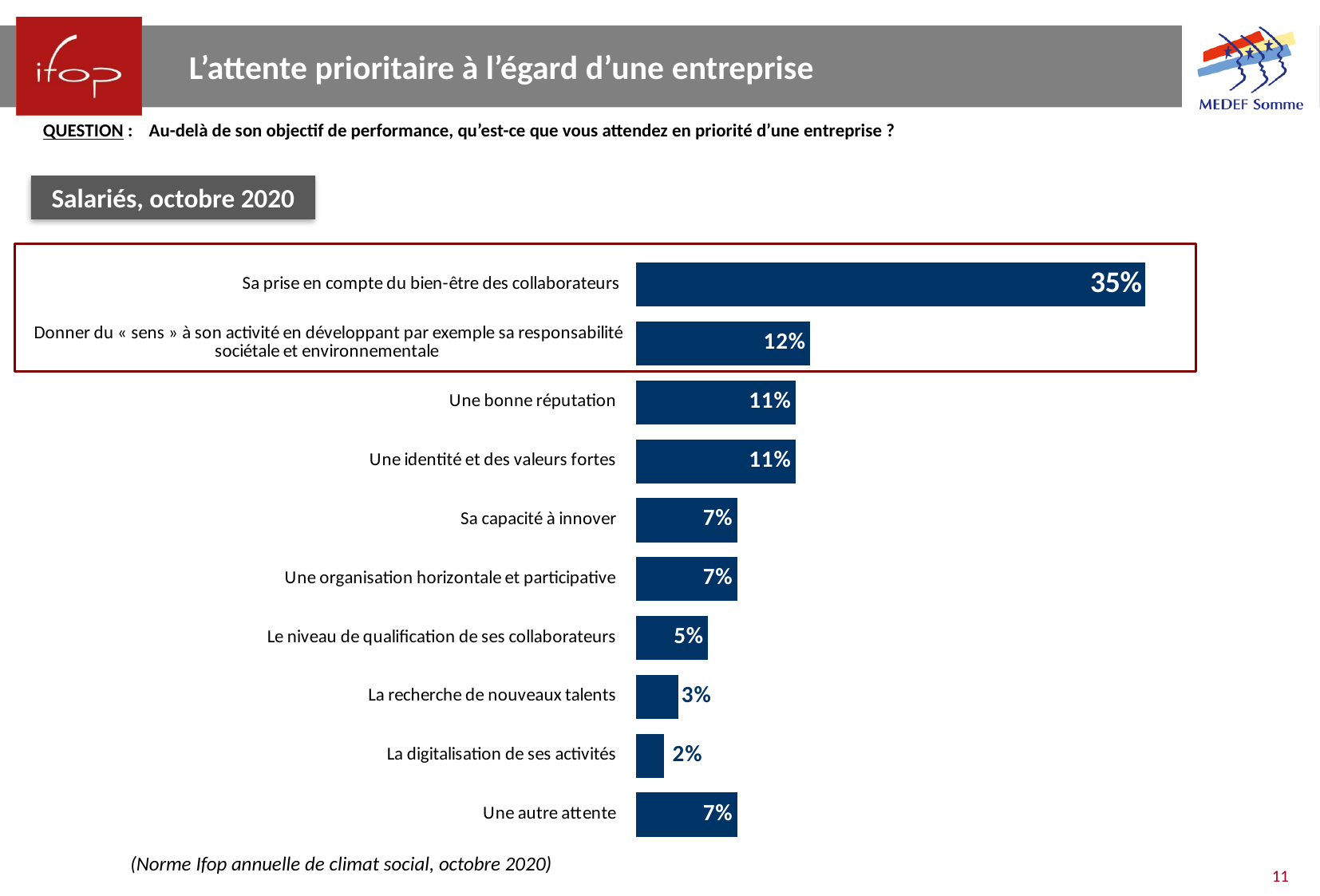
What is the difference between the values for "Sa prise en compte du bien-être des collaborateurs" and "Une bonne réputation"? 24% What kind of chart is shown on the slide? Bar chart How many categories are shown in the chart? 10 Which category has the highest value? Sa prise en compte du bien-être des collaborateurs What is the value for "Le niveau de qualification de ses collaborateurs"? 5% What is the difference between the values for "Donner du « sens » à son activité..." and "La digitalisation de ses activités"? 10% What is the value for "Sa prise en compte du bien-être des collaborateurs"? 35% What is the value for "Une bonne réputation"? 11% What population and date does the label above the chart indicate? Salariés, octobre 2020 What is the value for "La digitalisation de ses activités"? 2% Which category has the lowest value? La digitalisation de ses activités Which is larger: the value for "Sa capacité à innover" or the value for "La recherche de nouveaux talents"? Sa capacité à innover